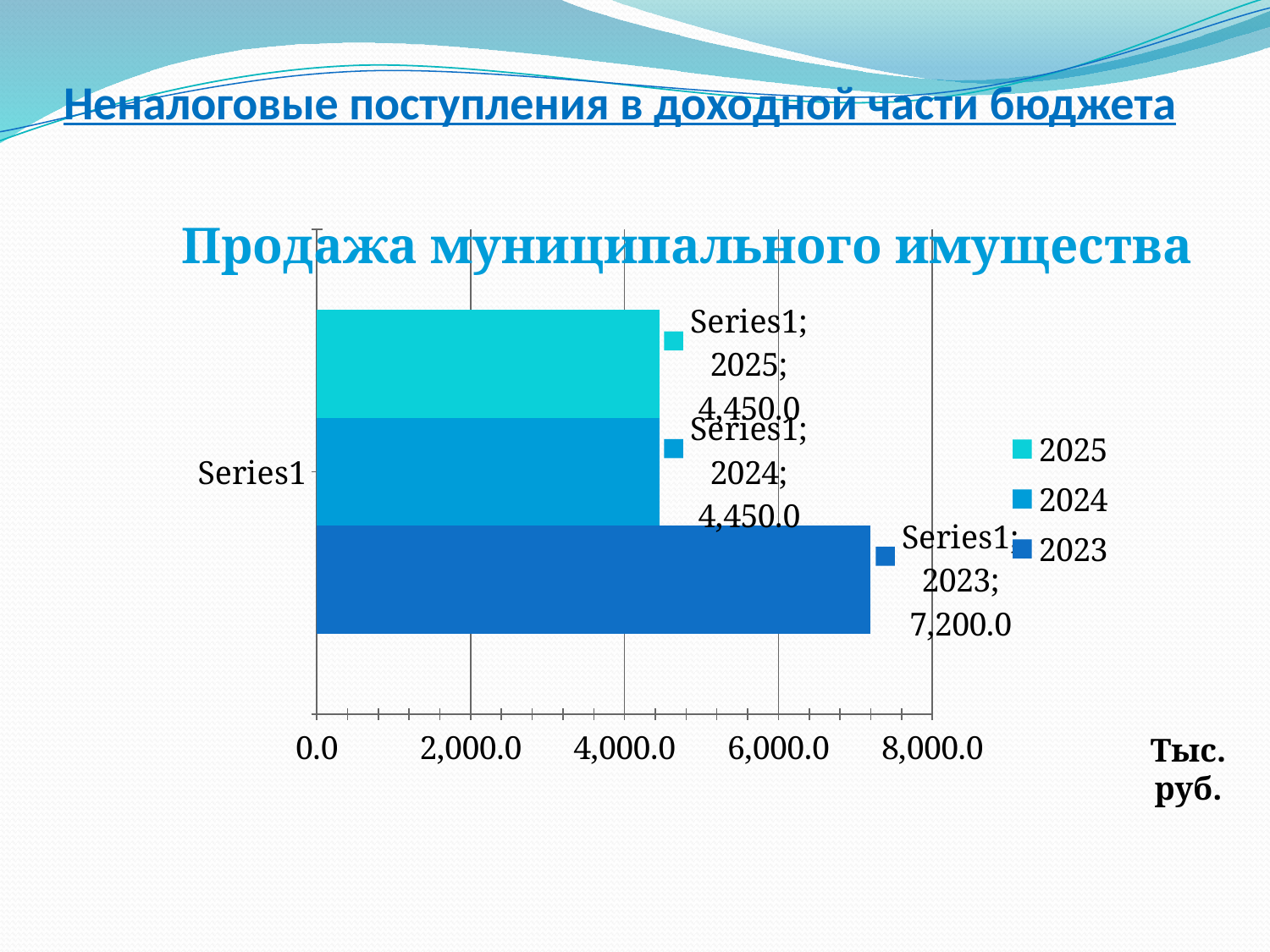
What is the title of the chart? Продажа муниципального имущества What is the value for 2024 in the chart? 4,450.0 How many series does the legend list? 3 What is the value for 2025 in the chart? 4,450.0 Is the value for 2025 greater or less than 6,000.0? less What is the difference between the values for 2023 and 2025? 2,750.0 Is the value for 2023 greater or less than 6,000.0? greater What unit is indicated next to the chart's axis? Тыс. руб. Which is larger, the value for 2023 or the value for 2024? 2023 What kind of chart is shown on the slide? bar chart Which year has the highest value in the chart? 2023 What is the value for 2023 in the chart? 7,200.0